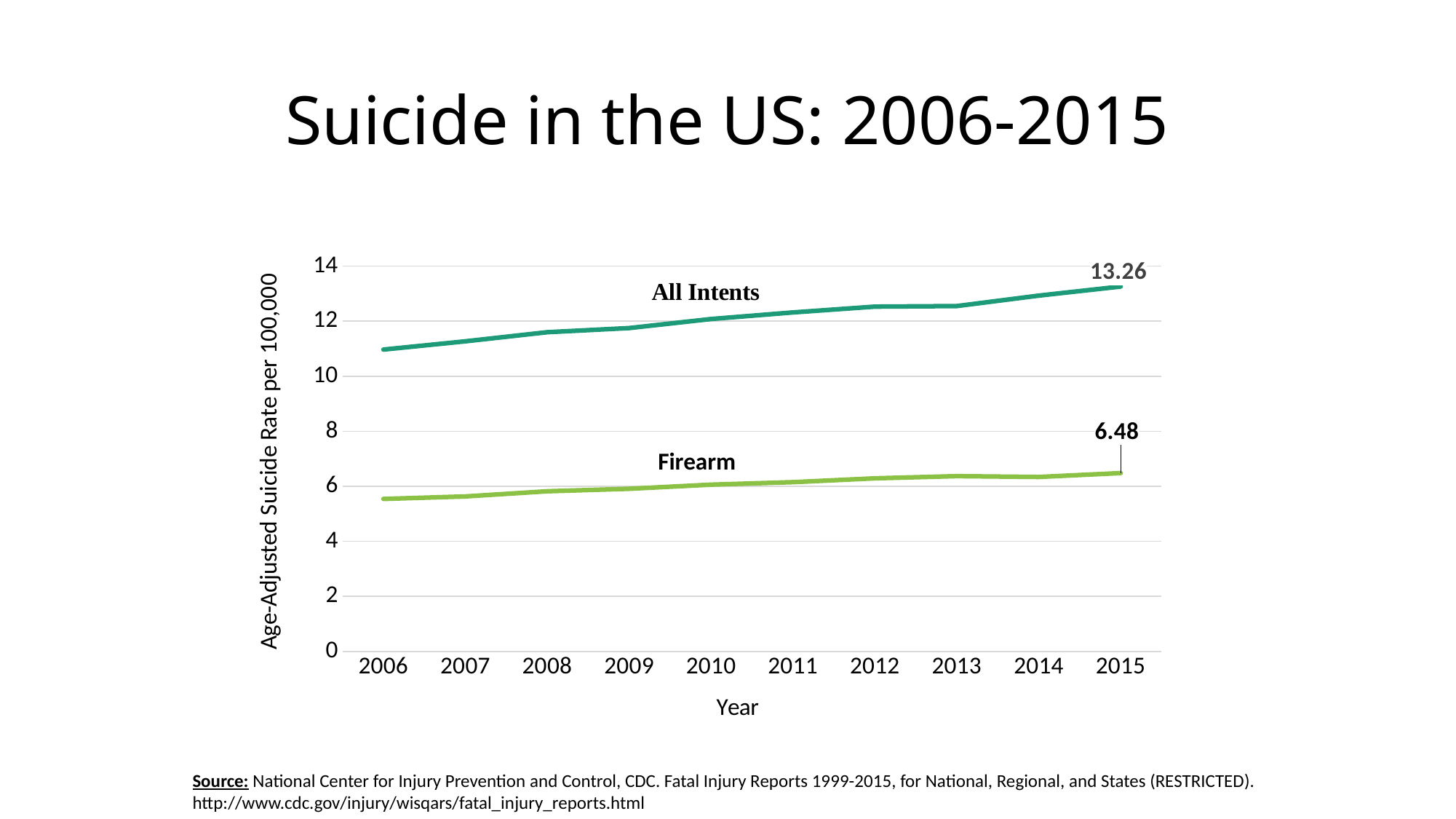
What type of chart is shown on the slide? line chart In 2015, which series has the higher value, All Intents or Firearm? All Intents How many years are plotted on the x axis? 10 How many data series are plotted on the chart? 2 Does the All Intents rate generally rise or fall from 2006 to 2015? rise What is the label of the y axis? Age-Adjusted Suicide Rate per 100,000 What is the All Intents age-adjusted suicide rate in 2015? 13.26 What is the difference between the All Intents rate and the Firearm rate in 2015? 6.78 What is the Firearm age-adjusted suicide rate in 2015? 6.48 Is the Firearm value for 2006 greater or less than 6? less Is the All Intents value for 2013 greater or less than 12? greater Is the All Intents value for 2006 greater or less than 10? greater